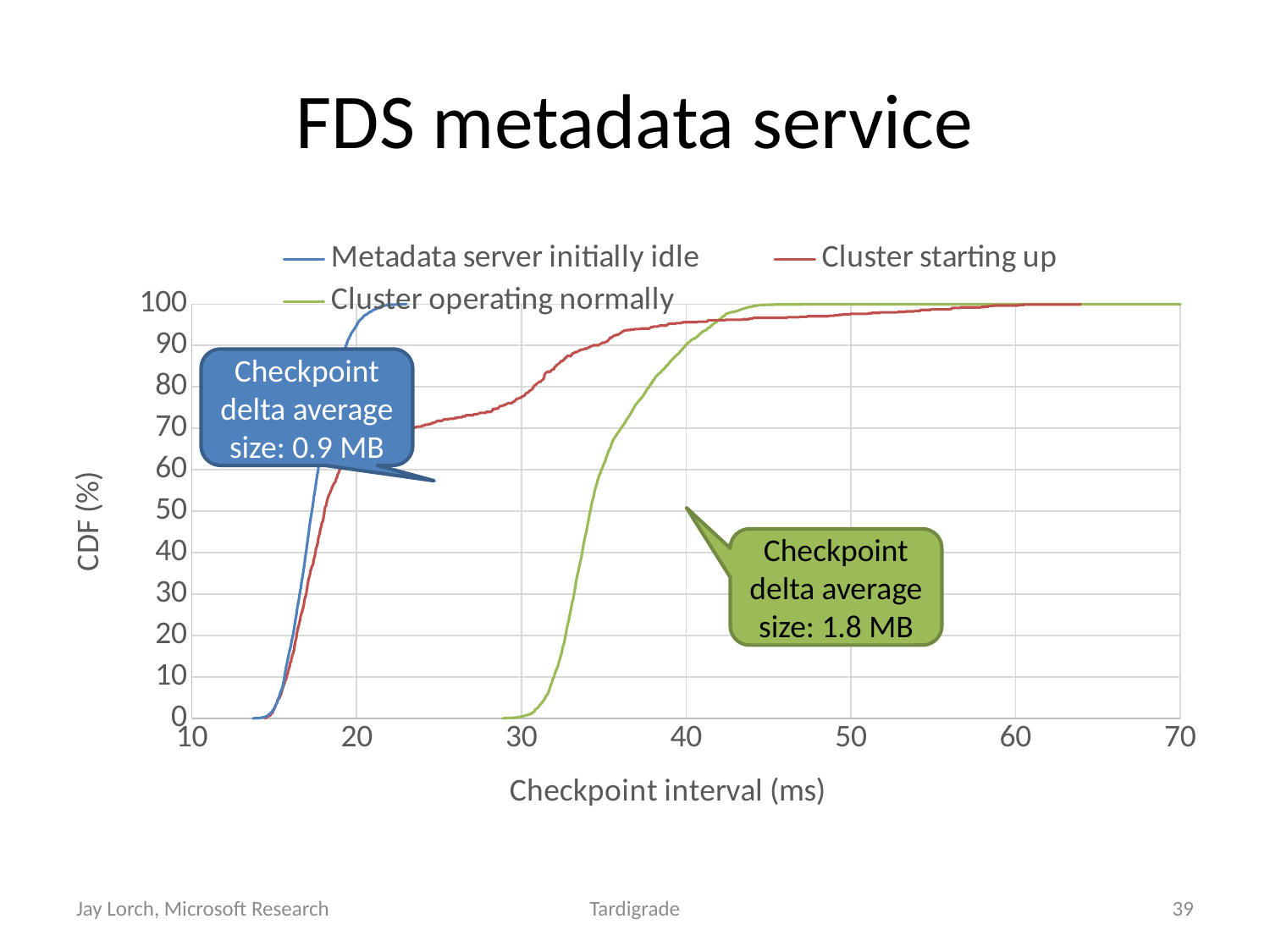
Is the CDF value for 'Cluster operating normally' at a checkpoint interval of 30 ms greater or less than 10? less Is the CDF value for 'Cluster starting up' at a checkpoint interval of 16 ms greater or less than 30? less What is the label of the x axis? Checkpoint interval (ms) What kind of chart is shown on the slide? line chart At a checkpoint interval of 35 ms, which series has the higher CDF value: 'Cluster starting up' or 'Cluster operating normally'? Cluster starting up Which series reaches a CDF of 100% at the smallest checkpoint interval? Metadata server initially idle How many series does the legend list? 3 Is the CDF value for 'Cluster operating normally' at a checkpoint interval of 35 ms greater or less than 50? greater Do the CDF values rise or fall as the checkpoint interval increases along the x axis? rise According to the blue callout, what is the checkpoint delta average size for the metadata server initially idle case? 0.9 MB